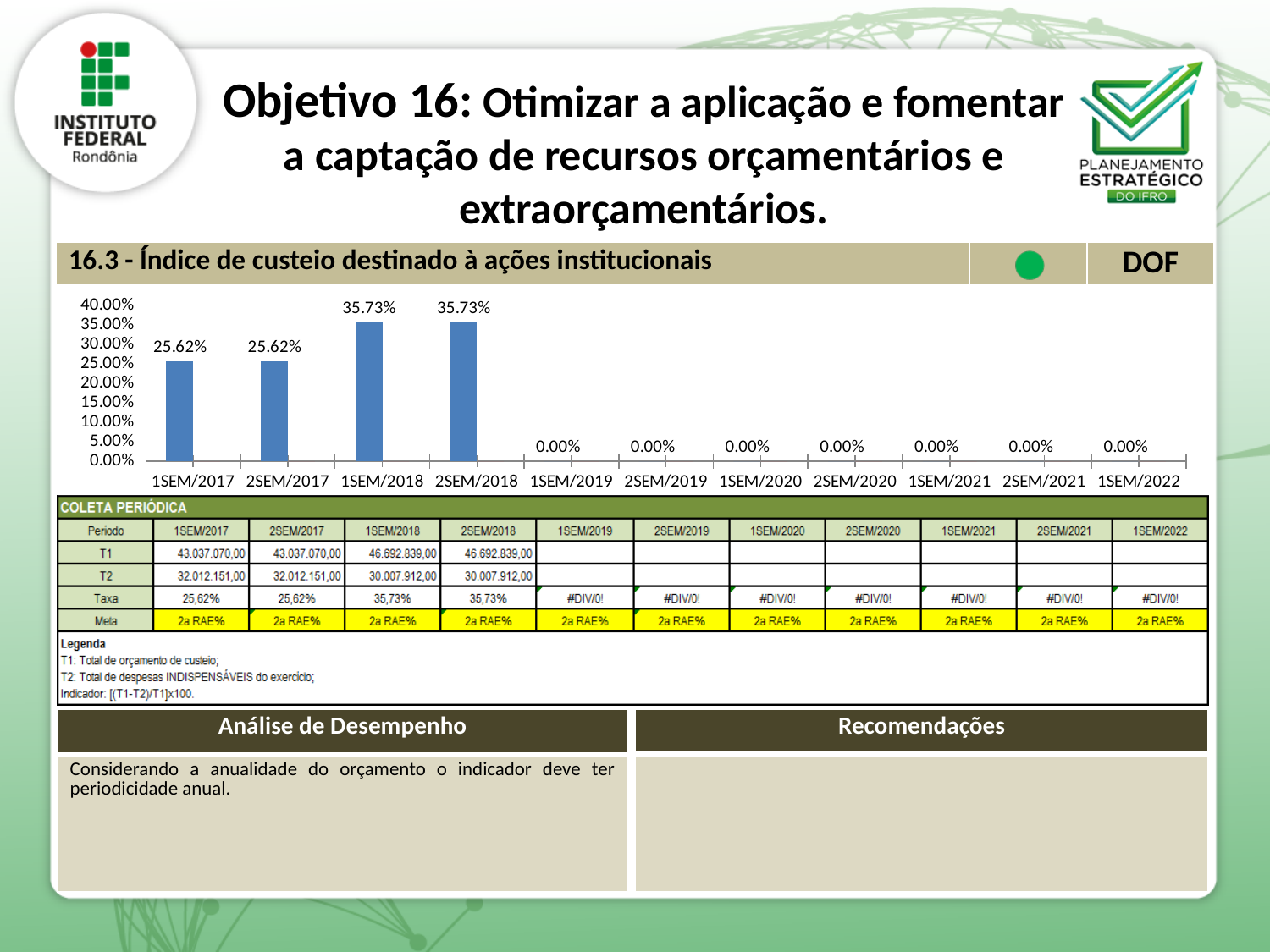
What is the value for 2SEM/2017? 25.62% What is the value for 1SEM/2018? 35.73% What kind of chart is shown on the slide? bar chart How many periods in the chart have a value of 0.00%? 7 What is the value for 1SEM/2020? 0.00% Is the value for 2SEM/2018 greater or less than 40.00%? less What is the difference between the values for 1SEM/2018 and 1SEM/2017? 10.11% What is the highest value shown on the y axis of the chart? 40.00% How many periods are shown on the x axis of the chart? 11 What is the value for 2SEM/2018? 35.73% Which is larger, the value for 2SEM/2018 or the value for 2SEM/2017? 2SEM/2018 Is the value for 1SEM/2017 greater or less than 20.00%? greater